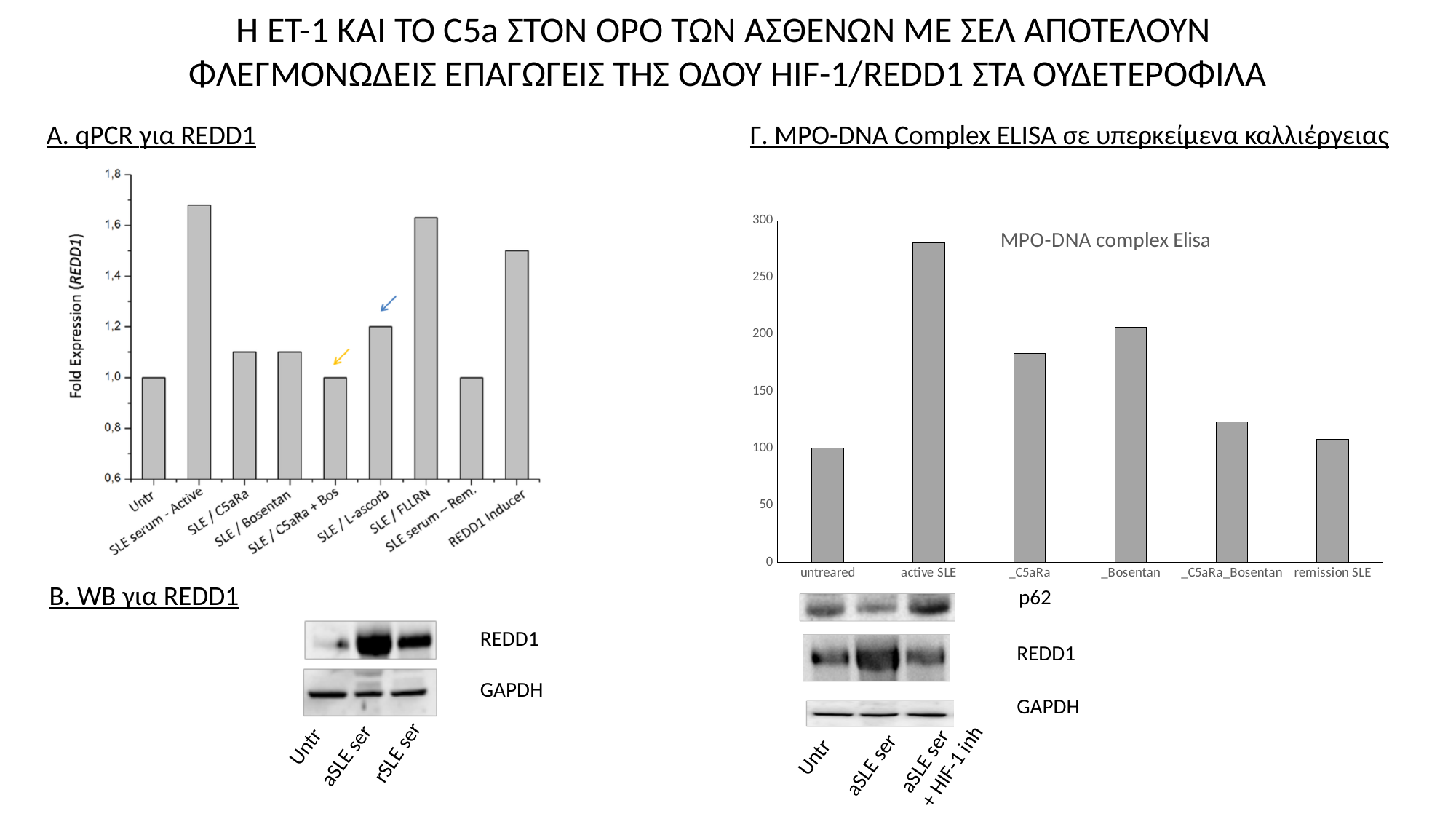
In the MPO-DNA complex Elisa chart, which category has the highest value? active SLE In the qPCR για REDD1 chart, which category has the highest fold expression? SLE serum - Active In the MPO-DNA complex Elisa chart, which is larger, _C5aRa or remission SLE? _C5aRa In the qPCR για REDD1 chart, which is larger, SLE / FLLRN or SLE / L-ascorb? SLE / FLLRN What kind of chart is the qPCR για REDD1 chart? bar chart In the MPO-DNA complex Elisa chart, how many categories are shown? 6 In the qPCR για REDD1 chart, what is the fold expression for Untr? 1,0 In the qPCR για REDD1 chart, is the value for SLE / C5aRa greater or less than 1,2? less In the MPO-DNA complex Elisa chart, is the value for _Bosentan greater or less than 150? greater In the qPCR για REDD1 chart, is the value for REDD1 Inducer greater or less than 1,4? greater In the qPCR για REDD1 chart, how many categories are shown on the x axis? 9